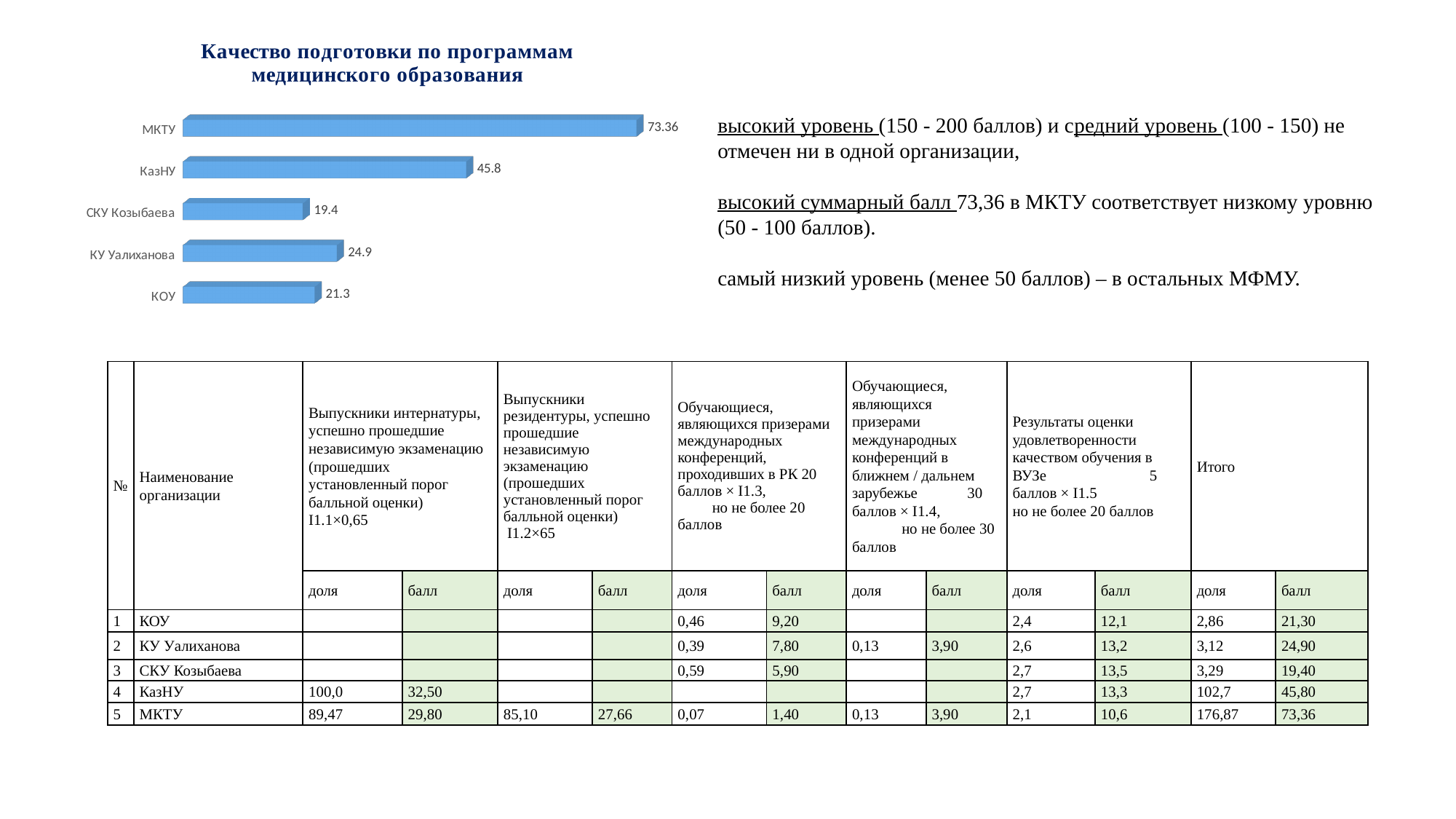
How many organisations are shown in the chart? 5 Which organisation has the lowest value in the chart? СКУ Козыбаева Which organisation has the highest value in the chart? МКТУ What is the value for СКУ Козыбаева in the chart? 19.4 Which has a larger value, КУ Уалиханова or КОУ? КУ Уалиханова What is the difference between the values for МКТУ and КазНУ? 27.56 What is the value for КазНУ in the chart? 45.8 What is the value for КОУ in the chart? 21.3 What is the value for КУ Уалиханова in the chart? 24.9 What type of chart is shown on the slide? Bar chart What is the value for МКТУ in the chart? 73.36 What is the title of the chart? Качество подготовки по программам медицинского образования